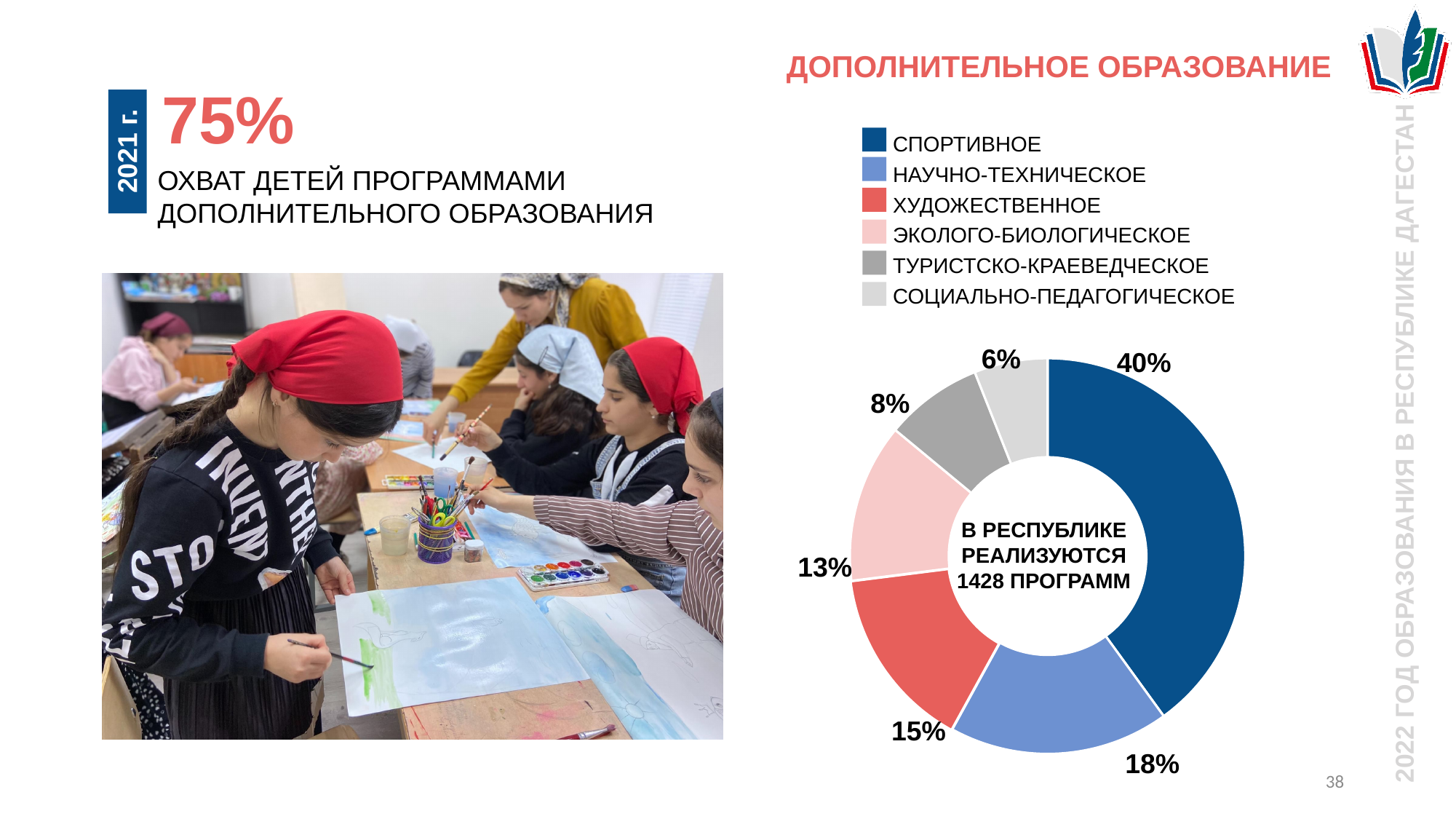
How many programs are stated in the centre of the donut chart? 1428 What share of the donut chart does СОЦИАЛЬНО-ПЕДАГОГИЧЕСКОЕ have? 6% What share of the donut chart does НАУЧНО-ТЕХНИЧЕСКОЕ have? 18% Which category has the smallest share in the donut chart? СОЦИАЛЬНО-ПЕДАГОГИЧЕСКОЕ How many categories does the legend of the donut chart list? 6 What is the difference in percentage points between СПОРТИВНОЕ and НАУЧНО-ТЕХНИЧЕСКОЕ? 22 What share of the donut chart does ЭКОЛОГО-БИОЛОГИЧЕСКОЕ have? 13% What kind of chart is shown on the slide? Pie (donut) chart What share of the donut chart does СПОРТИВНОЕ have? 40% What share of the donut chart does ХУДОЖЕСТВЕННОЕ have? 15% Which has a larger share, ТУРИСТСКО-КРАЕВЕДЧЕСКОЕ or ЭКОЛОГО-БИОЛОГИЧЕСКОЕ? ЭКОЛОГО-БИОЛОГИЧЕСКОЕ Which category has the largest share in the donut chart? СПОРТИВНОЕ